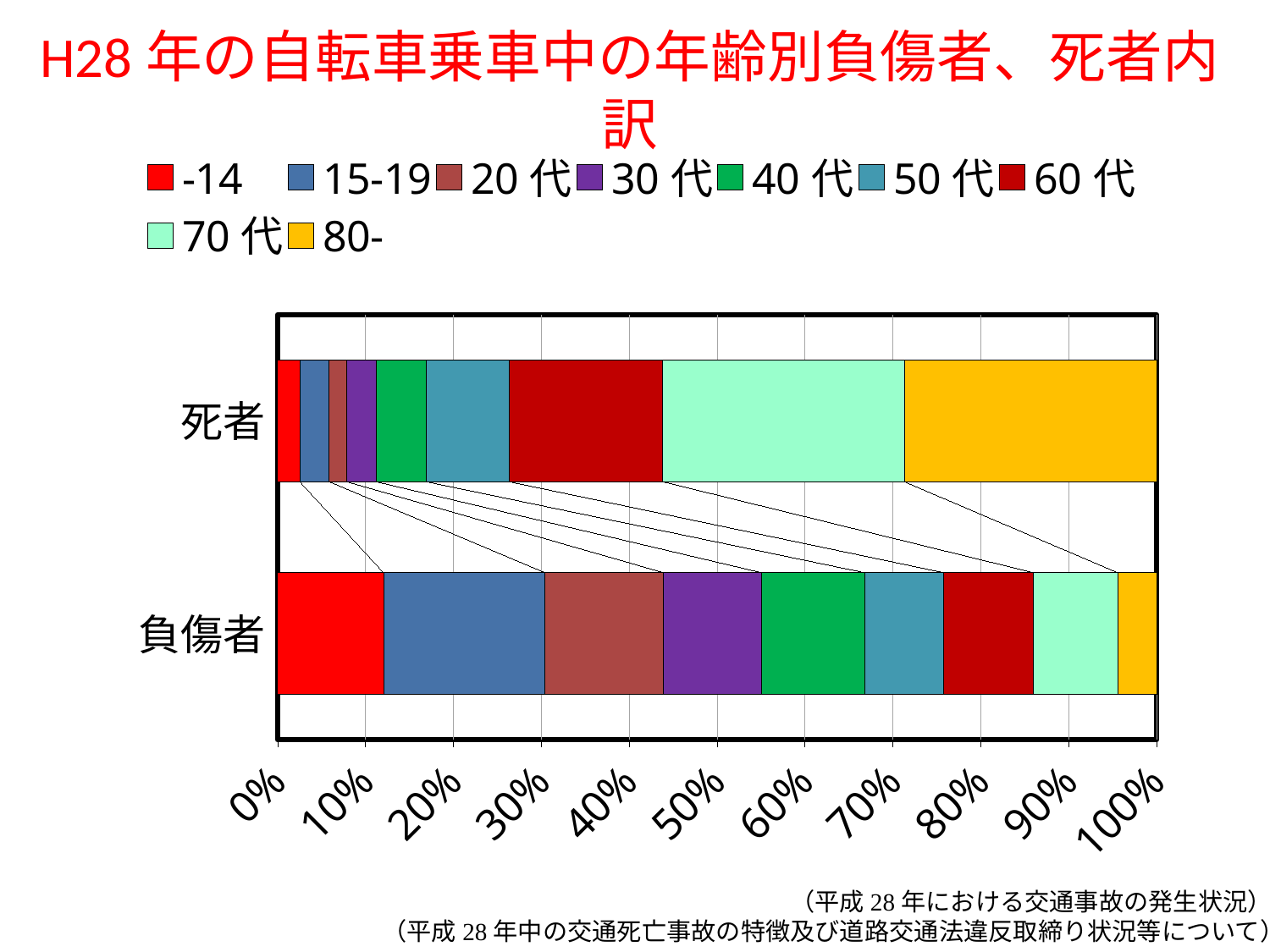
Is the share of the 80- age group larger in the 死者 bar or the 負傷者 bar? 死者 Is the share of the -14 age group in the 負傷者 bar greater or less than 20%? less What are the two categories shown on the vertical axis of the chart? 死者 and 負傷者 Is the share of the 70代 age group larger in the 死者 bar or the 負傷者 bar? 死者 What kind of chart is shown on the slide? Stacked bar chart Which age group has the smallest share of the 負傷者 bar? 80- How many series does the legend list? 9 Is the share of the -14 age group larger in the 死者 bar or the 負傷者 bar? 負傷者 What is the title of the slide's chart? H28年の自転車乗車中の年齢別負傷者、死者内訳 Is the share of the 80- age group in the 死者 bar greater or less than 20%? greater Which age group has the largest share of the 負傷者 bar? 15-19 How many categories (bars) does the chart show? 2